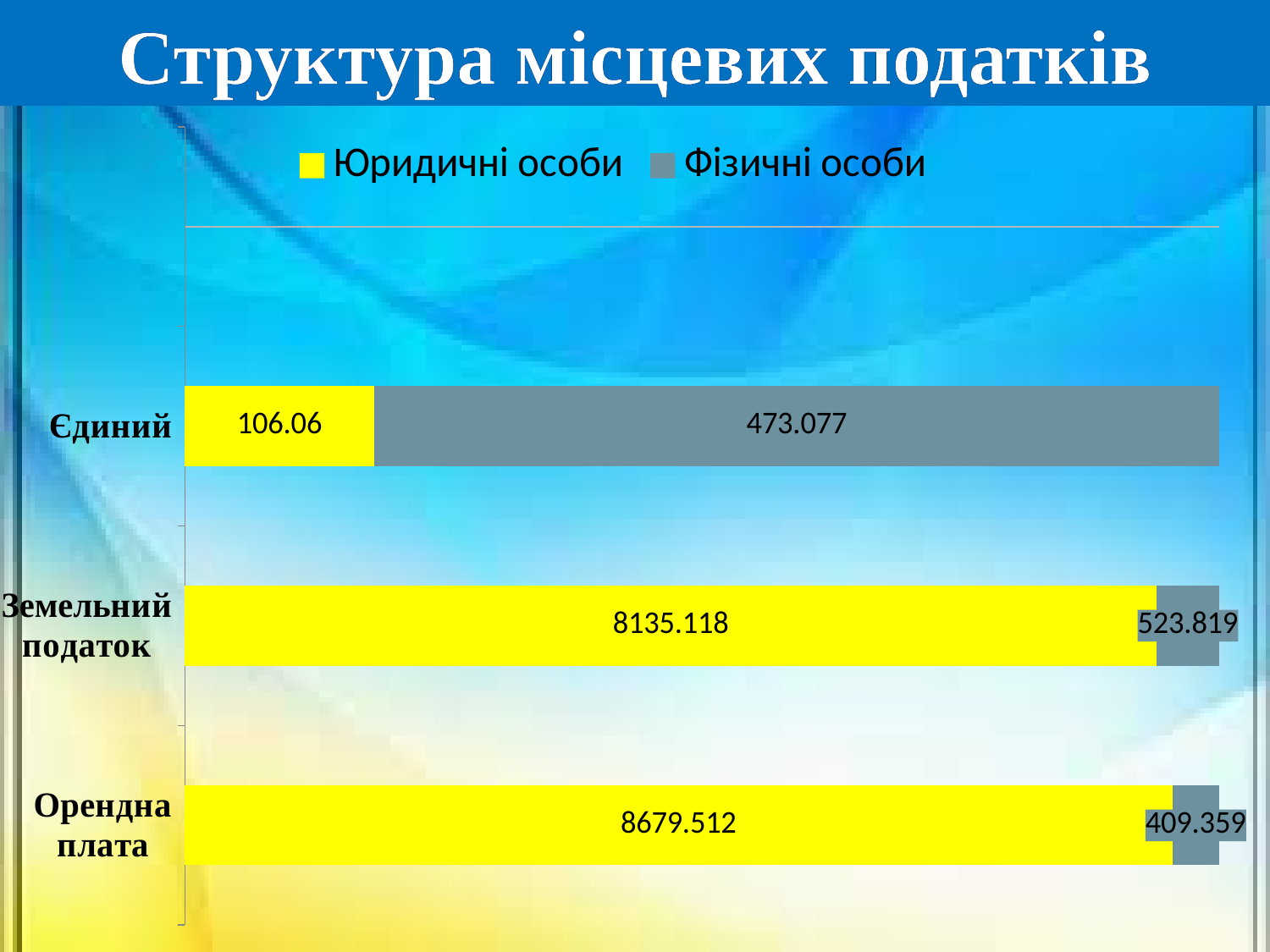
What is the value for Фізичні особи in the Орендна плата category? 409.359 How many categories are shown on the chart? 3 What type of chart is shown on the slide? bar chart Which category has the lowest value for Фізичні особи? Орендна плата What is the value for Фізичні особи in the Єдиний category? 473.077 Which series is shown in yellow? Юридичні особи What is the difference between the Юридичні особи values for Орендна плата and Земельний податок? 544.394 What is the value for Юридичні особи in the Земельний податок category? 8135.118 What is the value for Юридичні особи in the Єдиний category? 106.06 How many series does the legend list? 2 Which category has the highest value for Юридичні особи? Орендна плата Which is larger: the Фізичні особи value for Земельний податок or for Орендна плата? Земельний податок